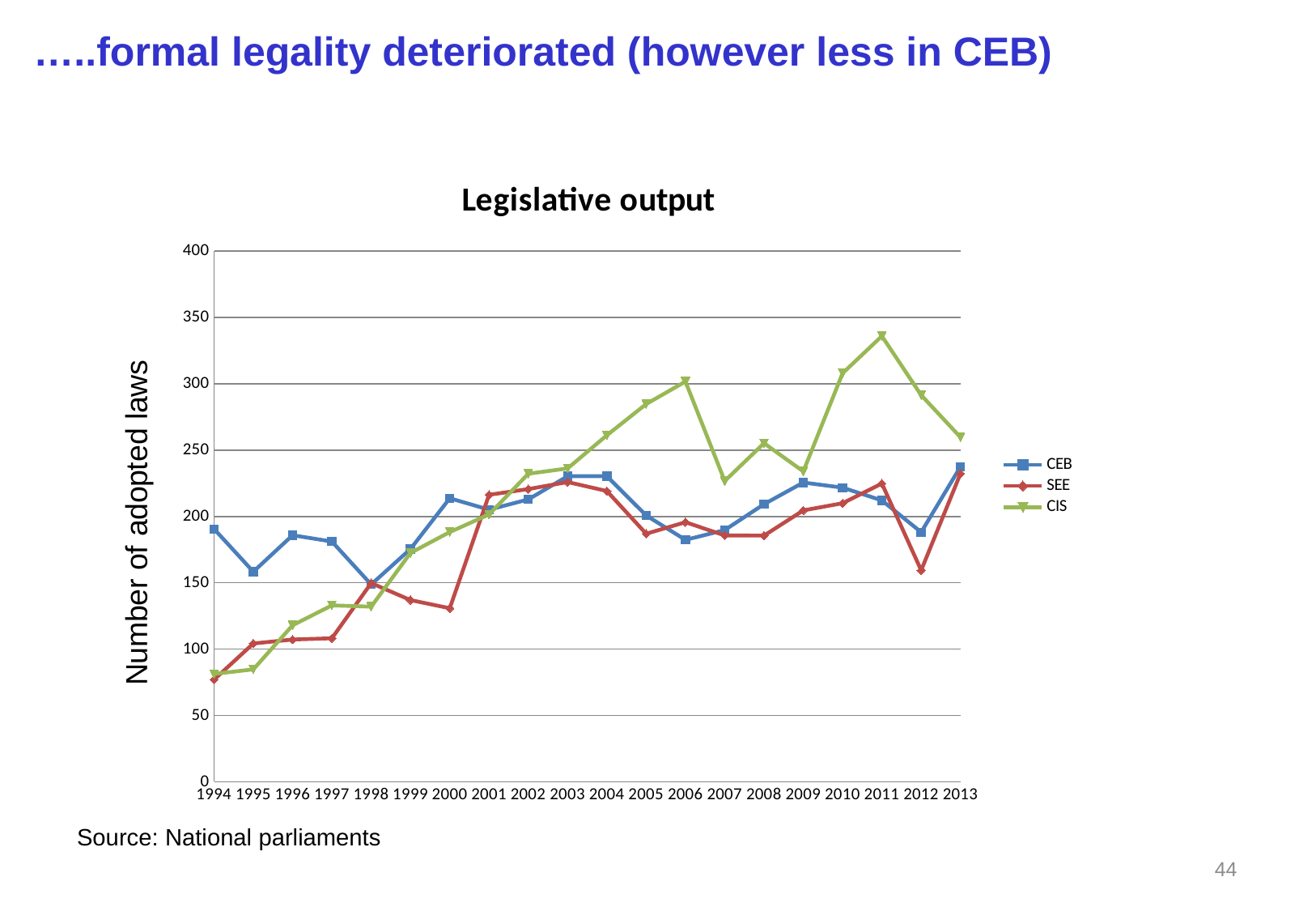
In 2010, which series has the larger value, CIS or CEB? CIS What is the title of the chart? Legislative output Does the SEE series rise or fall between 1994 and 2003? rise In which year does the CIS series reach its highest value? 2011 Which series has the lowest value in 2012? SEE What is the label of the y axis? Number of adopted laws How many series does the legend list? 3 Is the value for CEB in 2000 greater or less than 200? greater What kind of chart is shown on the slide? line chart Is the value for SEE in 1994 greater or less than 100? less How many years are shown on the x axis? 20 Is the value for CIS in 2011 greater or less than 300? greater